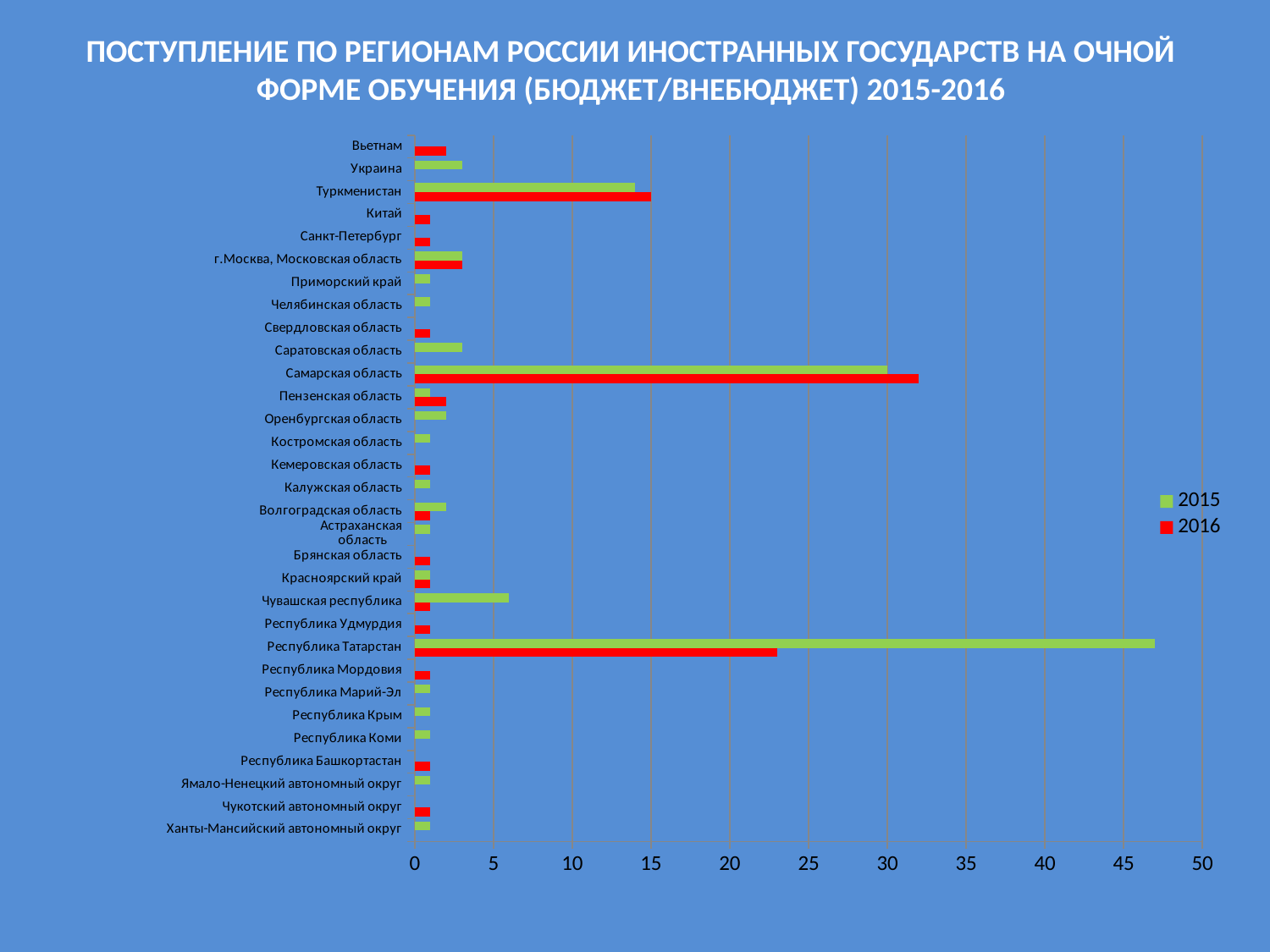
What kind of chart is shown on the slide? bar chart For Самарская область, which is larger: the 2015 value or the 2016 value? 2016 How many regions (categories) are listed on the vertical axis? 31 Is the 2015 value for Республика Татарстан greater or less than 45? greater For Республика Татарстан, which is larger: the 2015 value or the 2016 value? 2015 Which region has the highest value for 2016? Самарская область Is the 2016 value for Республика Татарстан greater or less than 25? less Which region has the highest value for 2015? Республика Татарстан Is the 2015 value for Чувашская республика greater or less than 5? greater What are the two series named in the legend? 2015 and 2016 How many series does the legend list? 2